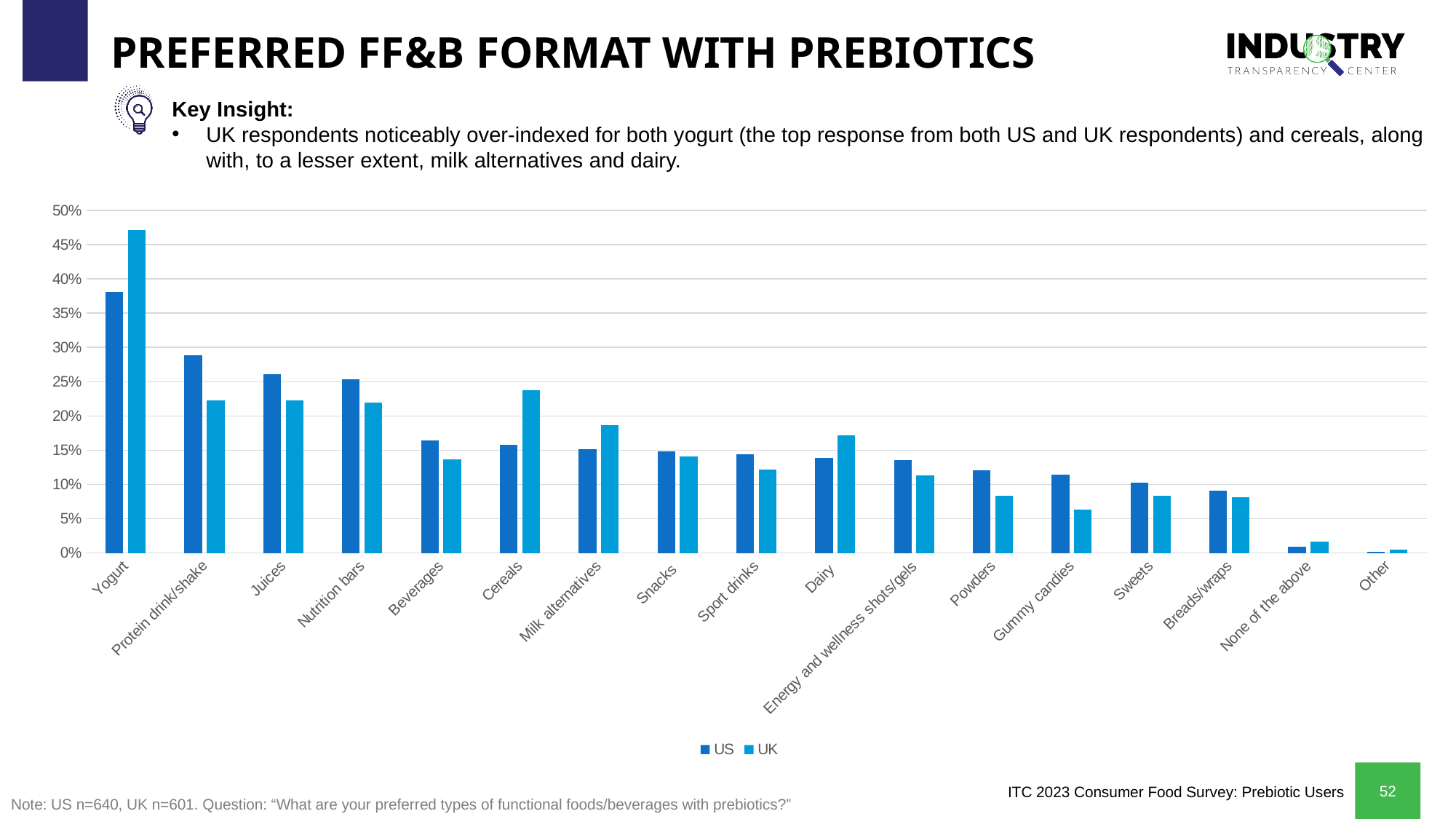
Is the UK value for Cereals greater or less than 20%? greater What kind of chart is shown on the slide? bar chart For Milk alternatives, which series has the larger value, US or UK? UK Which category has the lowest value for the US series? Other Do the US values generally rise or fall moving from left to right along the x axis? fall How many categories are shown on the x axis? 17 Which category has the highest value for the UK series? Yogurt Is the UK value for Gummy candies greater or less than 10%? less How many series does the legend list? 2 For Protein drink/shake, which series has the larger value, US or UK? US Is the US value for Yogurt greater or less than 40%? less